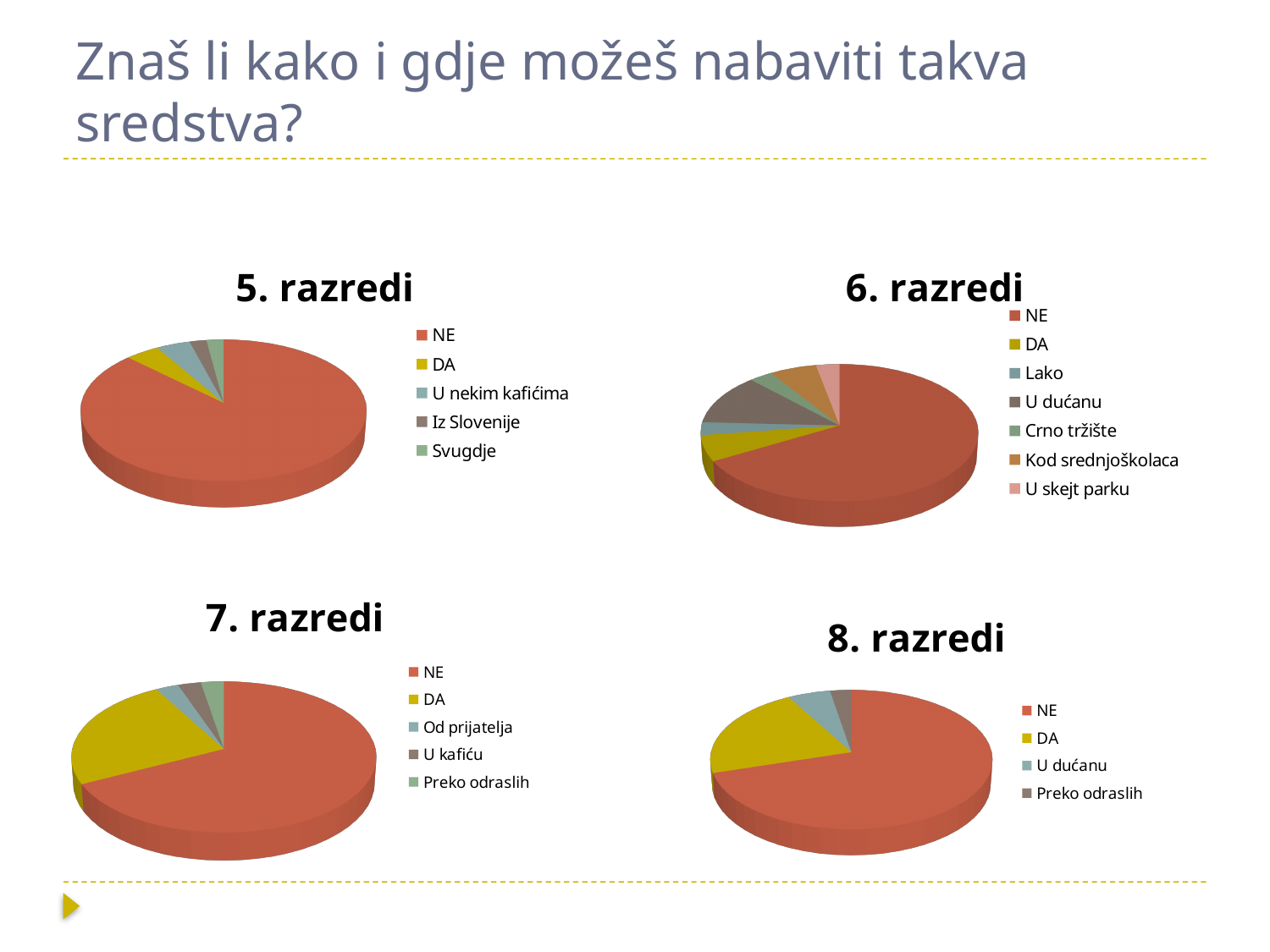
In the 6. razredi chart, which category has the largest slice? NE How many categories does the 5. razredi chart show? 5 In the 7. razredi chart, which slice is larger: DA or Od prijatelja? DA How many categories does the 6. razredi chart show? 7 In the 6. razredi chart, which slice is larger: U dućanu or Lako? U dućanu How many pie charts are on the slide? 4 What kind of chart is used for the 5. razredi chart? pie chart In the 7. razredi chart, which category has the largest slice? NE What is the title of the chart in the bottom-right of the slide? 8. razredi How many categories does the 8. razredi chart show? 4 In the 5. razredi chart, which category has the largest slice? NE In the 8. razredi chart, which slice is larger: DA or U dućanu? DA